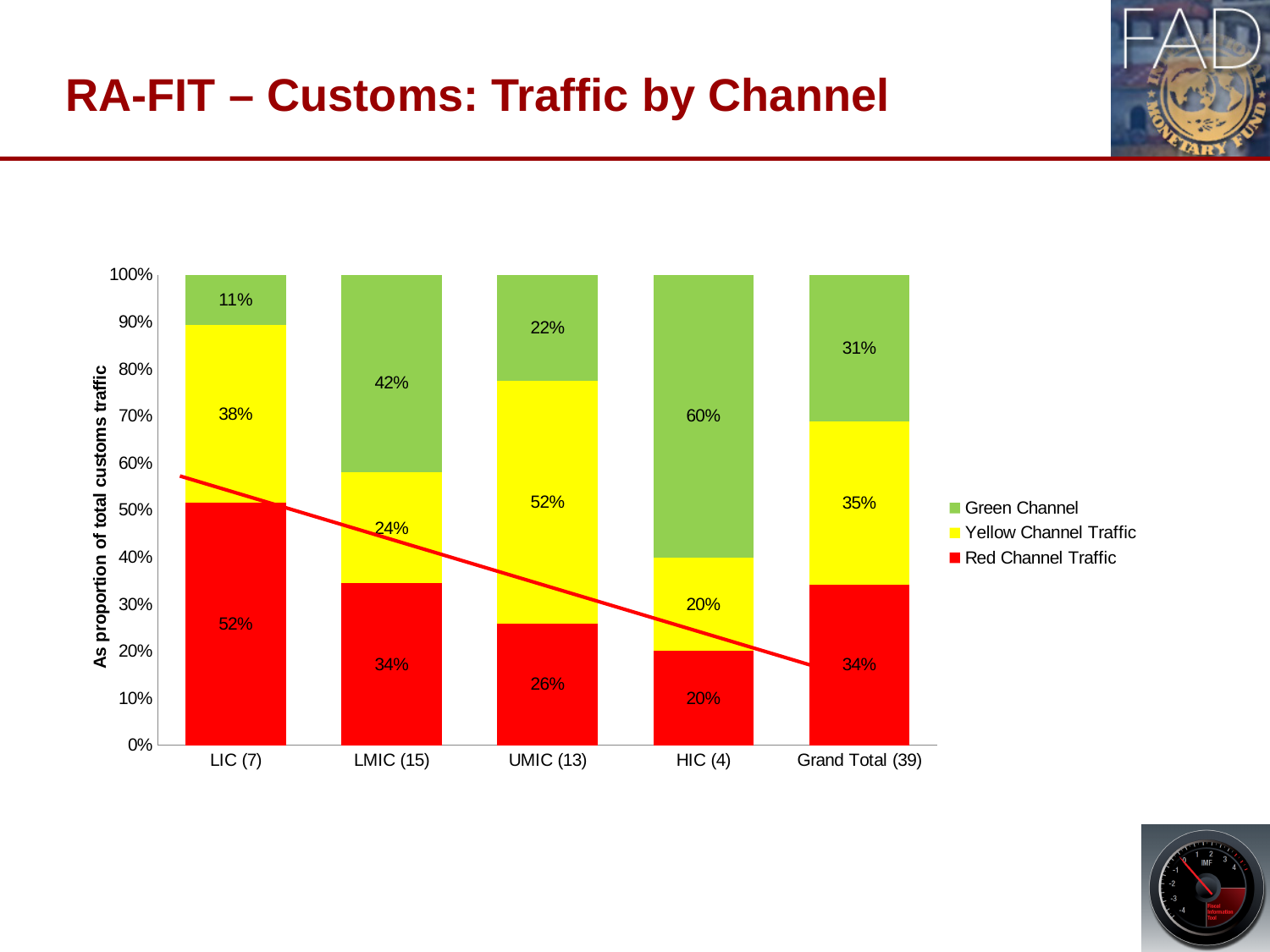
What is the y-axis title of the chart? As proportion of total customs traffic What is the Red Channel Traffic value for LIC (7)? 52% Which category has the highest Red Channel Traffic value? LIC (7) What is the difference between the Green Channel values for HIC (4) and LMIC (15)? 18% How many series does the legend list? 3 What kind of chart is shown on the slide? Stacked bar chart Which category has the lowest Green Channel value? LIC (7) How many categories are shown on the x axis? 5 What is the Green Channel value for Grand Total (39)? 31% Which is larger, the Yellow Channel Traffic value for LMIC (15) or for HIC (4)? LMIC (15) What is the Yellow Channel Traffic value for UMIC (13)? 52% What is the Green Channel value for HIC (4)? 60%